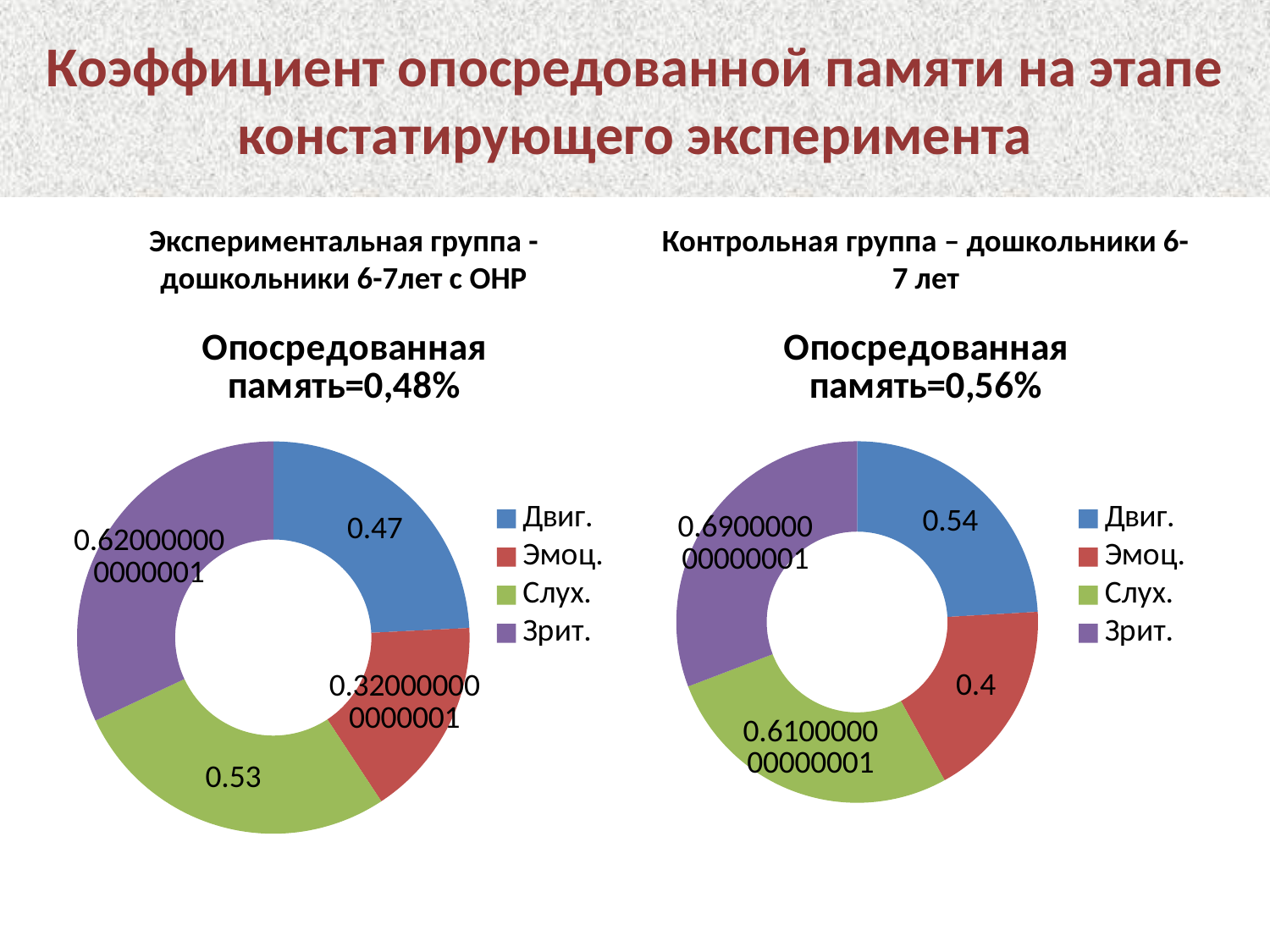
In the right chart (Опосредованная память=0,56%), which is larger, the value for Двиг. or the value for Эмоц.? Двиг. In the right chart (Опосредованная память=0,56%), what is the value for Эмоц.? 0.4 In the left chart (Опосредованная память=0,48%), what is the value for Двиг.? 0.47 In the left chart (Опосредованная память=0,48%), what is the value for Слух.? 0.53 In the right chart (Опосредованная память=0,56%), what is the value for Двиг.? 0.54 In the right chart (Опосредованная память=0,56%), which category has the largest value? Зрит. In the right chart (Опосредованная память=0,56%), which category has the smallest value? Эмоц. What kind of chart is the right chart (Опосредованная память=0,56%)? doughnut chart In the left chart (Опосредованная память=0,48%), which category has the largest value? Зрит. How many categories does the legend of the left chart (Опосредованная память=0,48%) list? 4 In the left chart (Опосредованная память=0,48%), which category has the smallest value? Эмоц. In the left chart (Опосредованная память=0,48%), what is the difference between the values for Слух. and Двиг.? 0.06